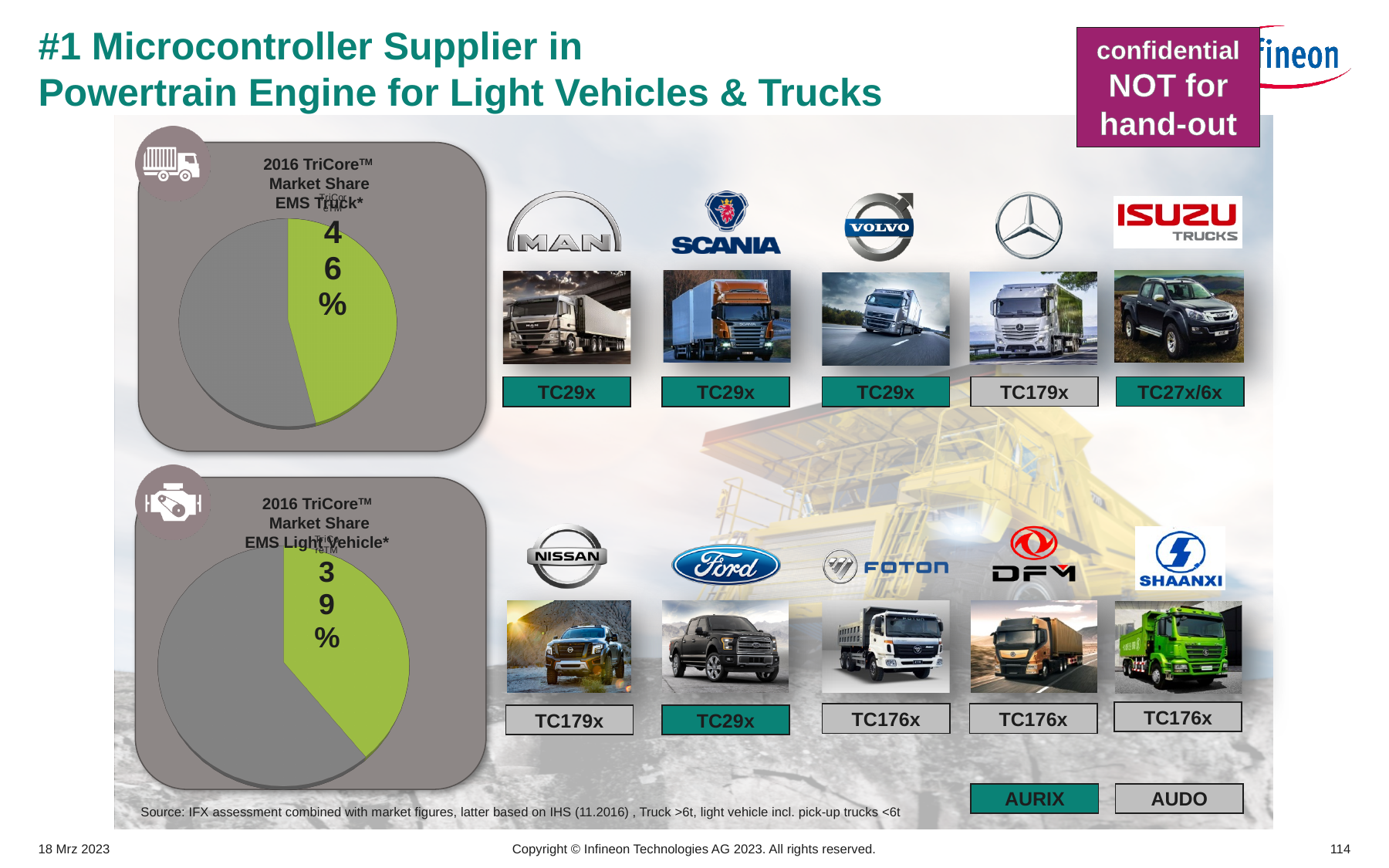
What is the title of the lower pie chart on the slide? 2016 TriCore Market Share EMS Light Vehicle* In the 2016 TriCore Market Share EMS Light Vehicle chart, which slice is larger, the green slice or the grey slice? grey How many slices does the 2016 TriCore Market Share EMS Truck pie chart have? 2 In the 2016 TriCore Market Share EMS Truck chart, which slice is larger, the green slice or the grey slice? grey In the 2016 TriCore Market Share EMS Truck chart, is the green slice greater or less than 50%? less What kind of chart is used to show the 2016 TriCore Market Share EMS Truck data? pie chart Which chart shows a larger labeled green share, the EMS Truck chart or the EMS Light Vehicle chart? EMS Truck In the 2016 TriCore Market Share EMS Light Vehicle chart, what percentage is printed on the green slice? 39% In the 2016 TriCore Market Share EMS Truck chart, what percentage is printed on the green slice? 46% What colour is the slice that carries the percentage label in both pie charts? green What is the difference between the labeled share in the EMS Truck chart (46%) and the labeled share in the EMS Light Vehicle chart (39%)? 7% How many pie charts are shown on the slide? 2